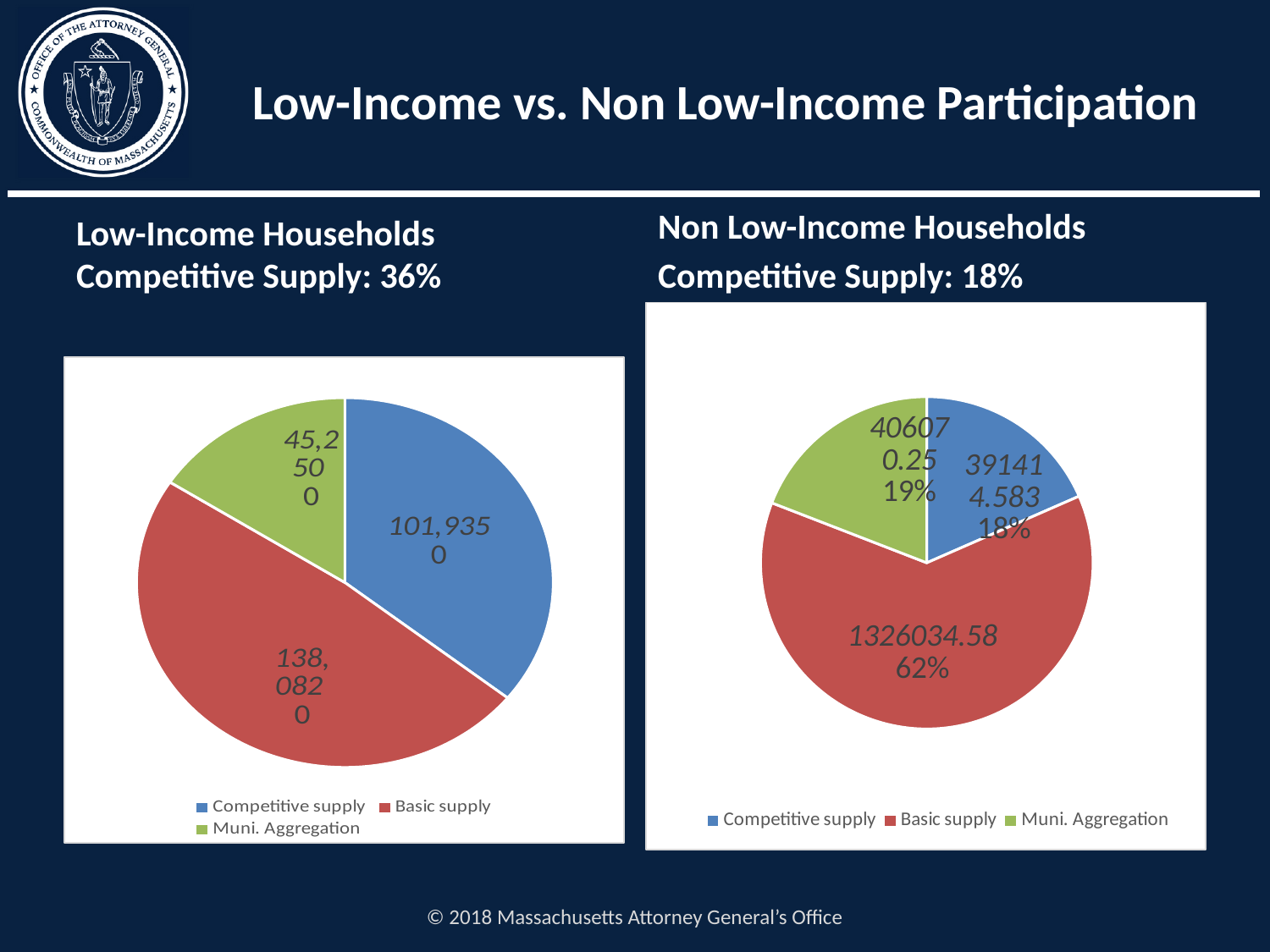
In the Non Low-Income Households chart, which category has the largest slice? Basic supply In the Non Low-Income Households chart, what is the value printed for Basic supply? 1326034.58 In the Non Low-Income Households chart, what share of the pie is Muni. Aggregation? 19% In the Non Low-Income Households chart, which category has the smallest slice? Competitive supply What kind of chart is the Low-Income Households chart on the left? Pie chart How many slices does the Non Low-Income Households pie chart have? 3 In the Low-Income Households chart, which category has the largest slice? Basic supply In the Non Low-Income Households chart, what is the difference in percentage points between the Basic supply share and the Muni. Aggregation share? 43% In the Low-Income Households chart, which slice is larger: Competitive supply or Muni. Aggregation? Competitive supply In the Low-Income Households chart, which category has the smallest slice? Muni. Aggregation In the Non Low-Income Households chart, what share of the pie is Competitive supply? 18% In the Non Low-Income Households chart, what share of the pie is Basic supply? 62%